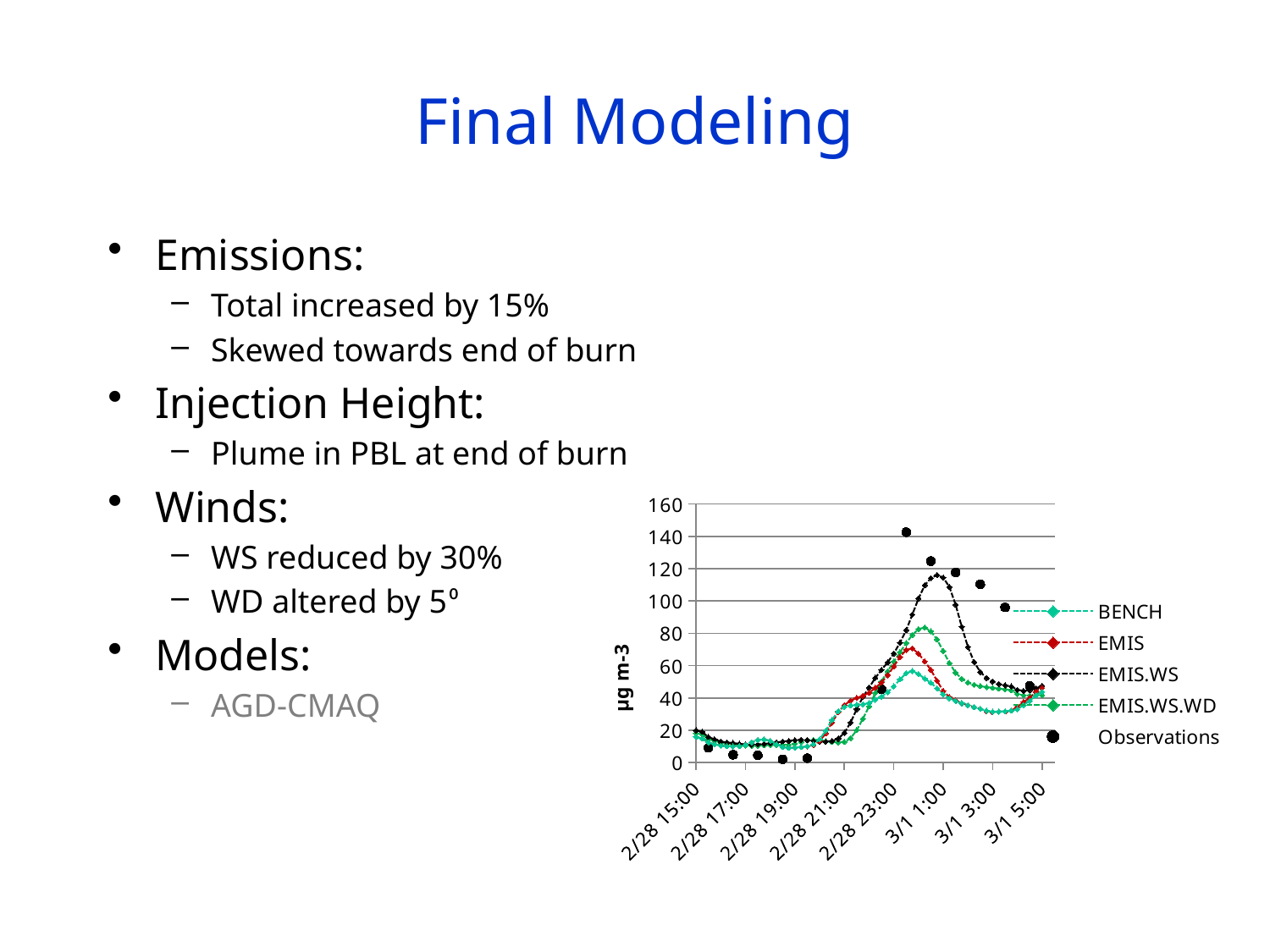
Is the peak value of the EMIS.WS line greater or less than 100? greater Which of the modeled lines reaches the highest peak value? EMIS.WS How many series does the chart legend list? 5 Is the peak value of the Observations series greater or less than 120? greater Is the peak value of the BENCH line greater or less than 80? less Which of the modeled lines has the lowest peak value? BENCH Which series in the chart is plotted as black dots without a connecting line? Observations What kind of chart is shown on the slide? line chart What is the label on the chart's vertical axis? µg m-3 Which reaches a higher peak, the EMIS.WS line or the EMIS.WS.WD line? EMIS.WS Do the values of the EMIS.WS line rise or fall between 2/28 21:00 and 3/1 1:00? rise